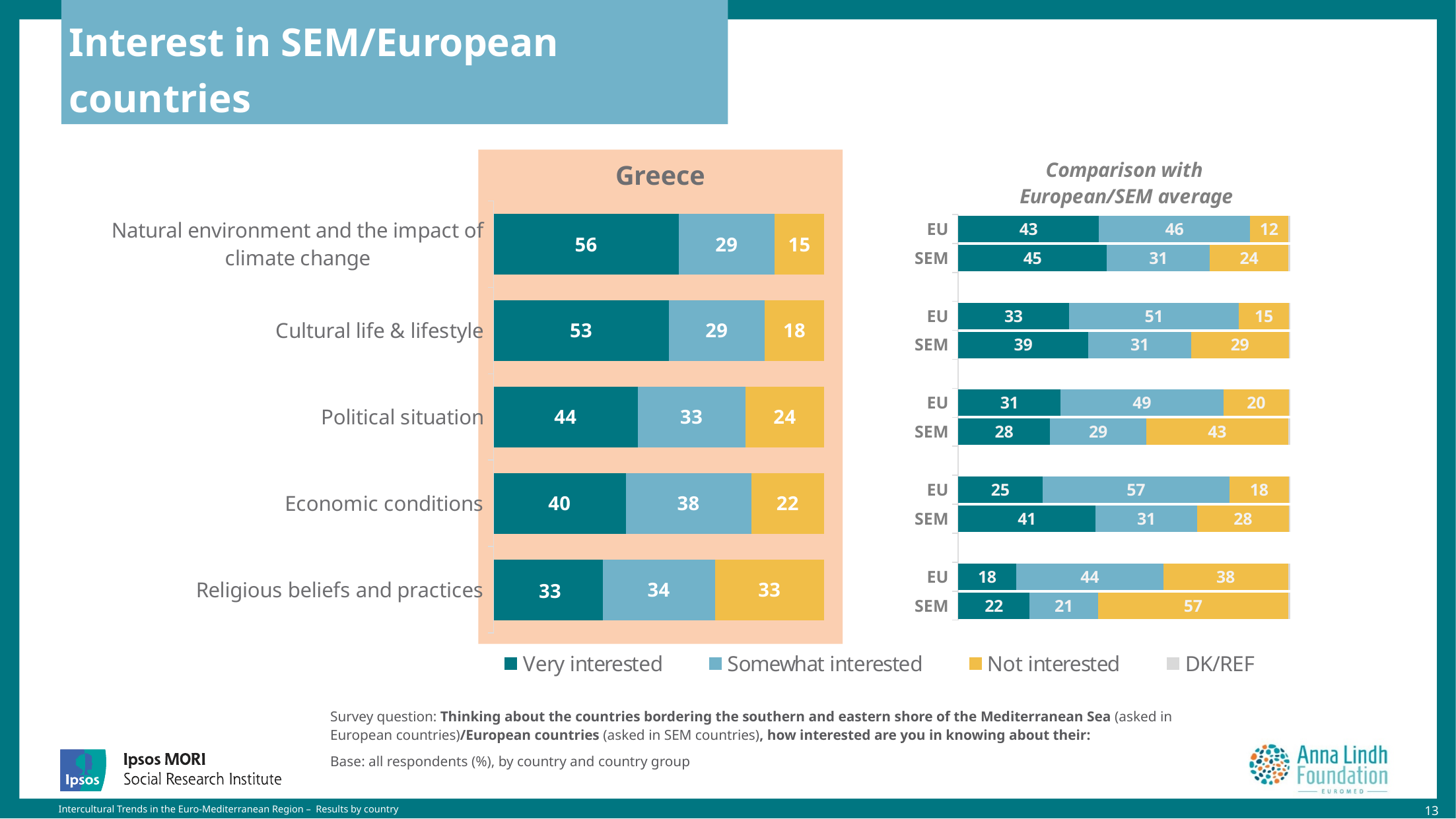
In the Greece chart, what is the difference between the 'Very interested' values for Cultural life & lifestyle and Economic conditions? 13 How many series does the legend list? 4 What kind of chart is the Greece chart? Stacked bar chart In the Greece chart, what percentage is 'Very interested' in the Natural environment and the impact of climate change? 56 In the Greece chart, which category has the lowest 'Very interested' value? Religious beliefs and practices In the Greece chart, what is the 'Not interested' value for Religious beliefs and practices? 33 In the Greece chart, which is larger: the 'Somewhat interested' value for Economic conditions or for Political situation? Economic conditions In the Greece chart, which category has the highest 'Very interested' value? Natural environment and the impact of climate change In the Comparison with European/SEM average chart, what is the 'Somewhat interested' value for the top EU bar? 46 In the Comparison with European/SEM average chart, what is the 'Not interested' value for the bottom SEM bar? 57 How many categories are shown in the Greece chart? 5 In the Greece chart, what is the total of the stacked bar for Political situation? 101